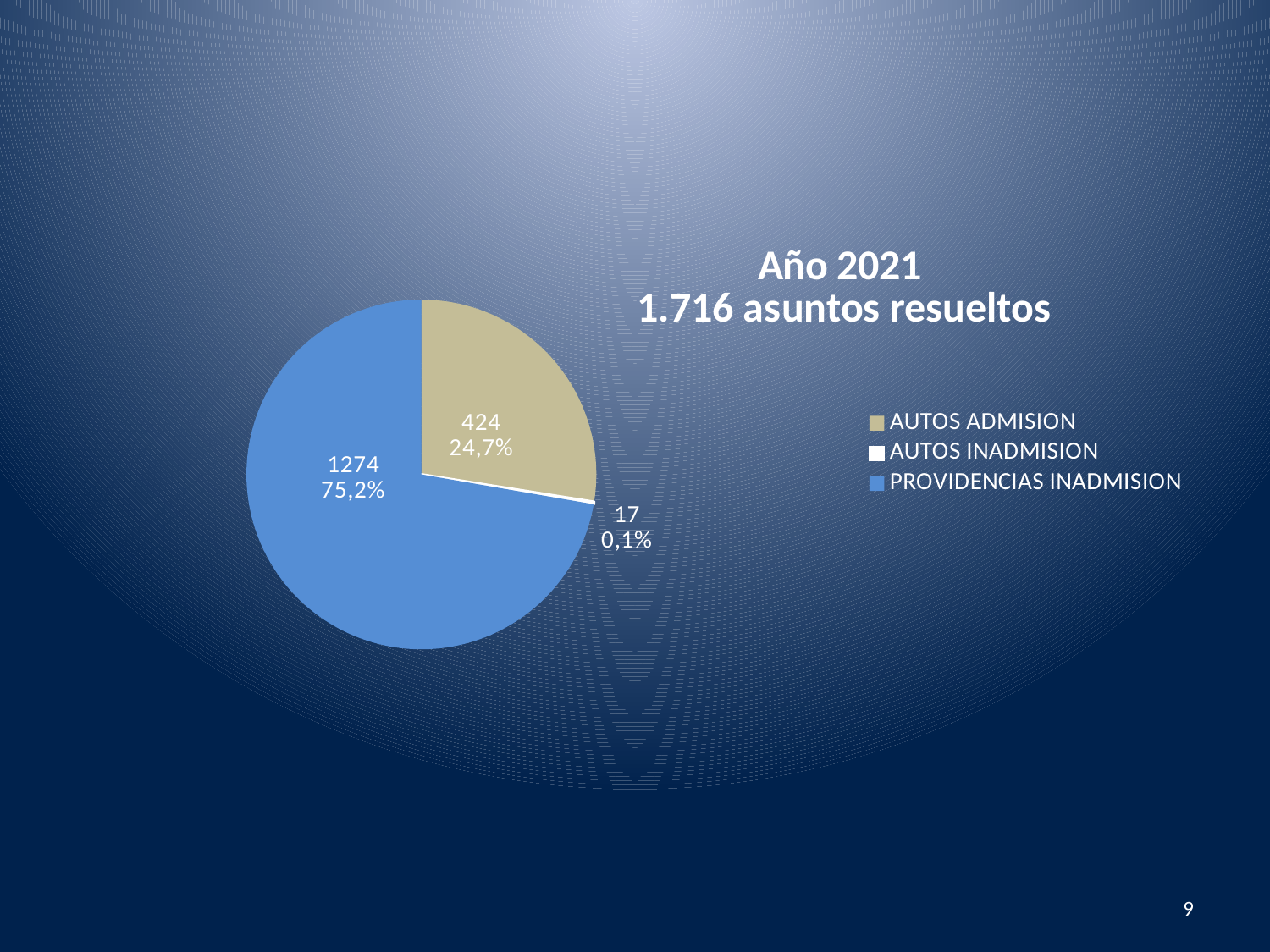
What is the value for AUTOS ADMISION? 424 How many entries does the legend list? 3 What is the difference between the values for PROVIDENCIAS INADMISION and AUTOS ADMISION? 850 Which category has the smallest slice? AUTOS INADMISION What is the title of the chart? Año 2021 1.716 asuntos resueltos What is the value for PROVIDENCIAS INADMISION? 1274 Which category has the largest slice? PROVIDENCIAS INADMISION What share of the pie does AUTOS ADMISION represent? 24,7% How many slices does the pie chart have? 3 What is the value for AUTOS INADMISION? 17 What kind of chart is shown on the slide? Pie chart What share of the pie does PROVIDENCIAS INADMISION represent? 75,2%